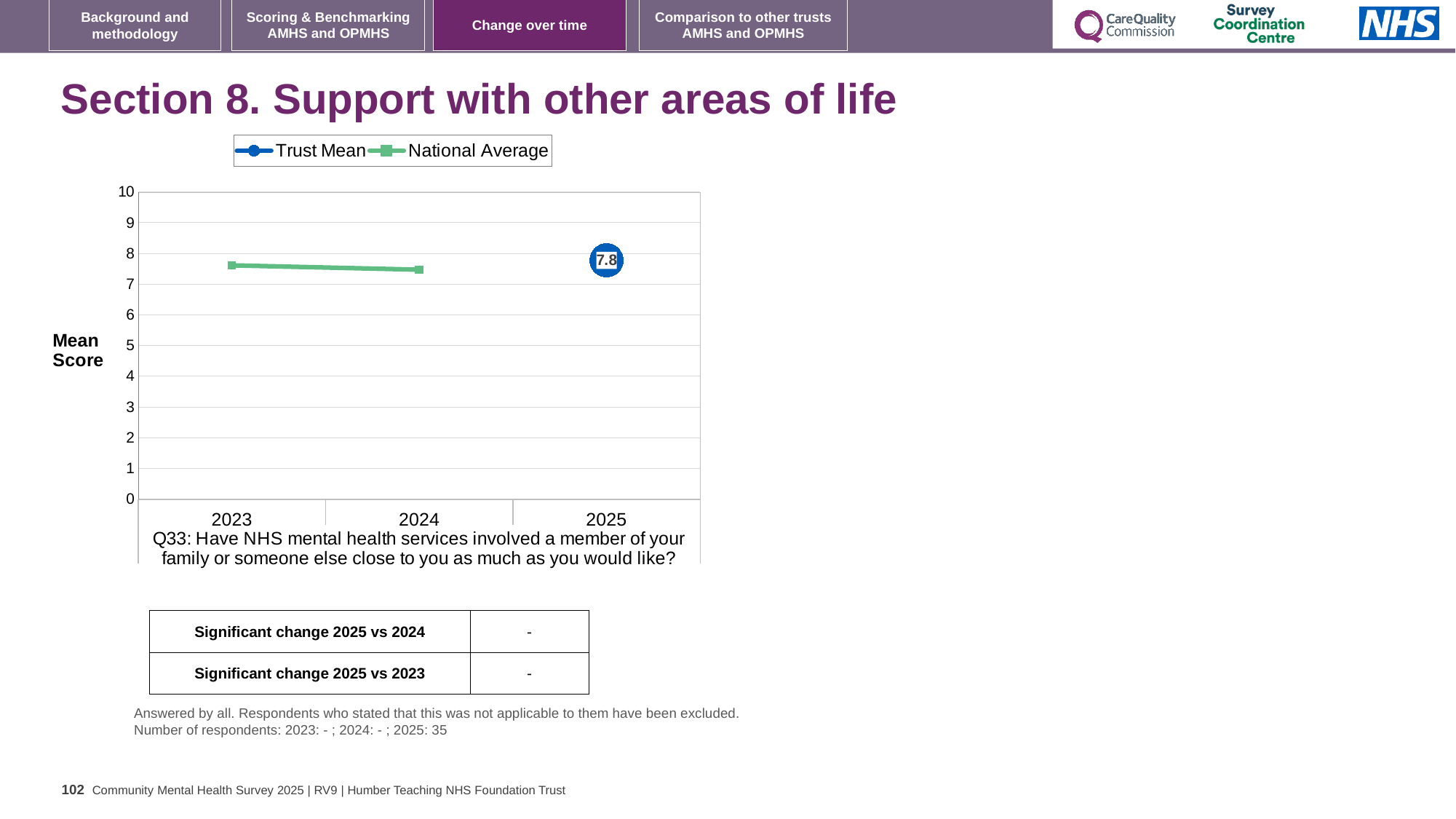
How many years are shown on the x axis? 3 What is the label on the y axis of the chart? Mean Score What is the Trust Mean value for 2025? 7.8 Is the National Average value for 2024 greater or less than 8? less Is the National Average value for 2023 greater or less than 7? greater Is the Trust Mean value for 2025 greater or less than 7? greater Which is larger: the Trust Mean for 2025 or the National Average for 2024? Trust Mean for 2025 How many series does the legend list? 2 What are the two series named in the legend? Trust Mean and National Average What kind of chart is shown on the slide? line chart Does the National Average rise or fall from 2023 to 2024? fall